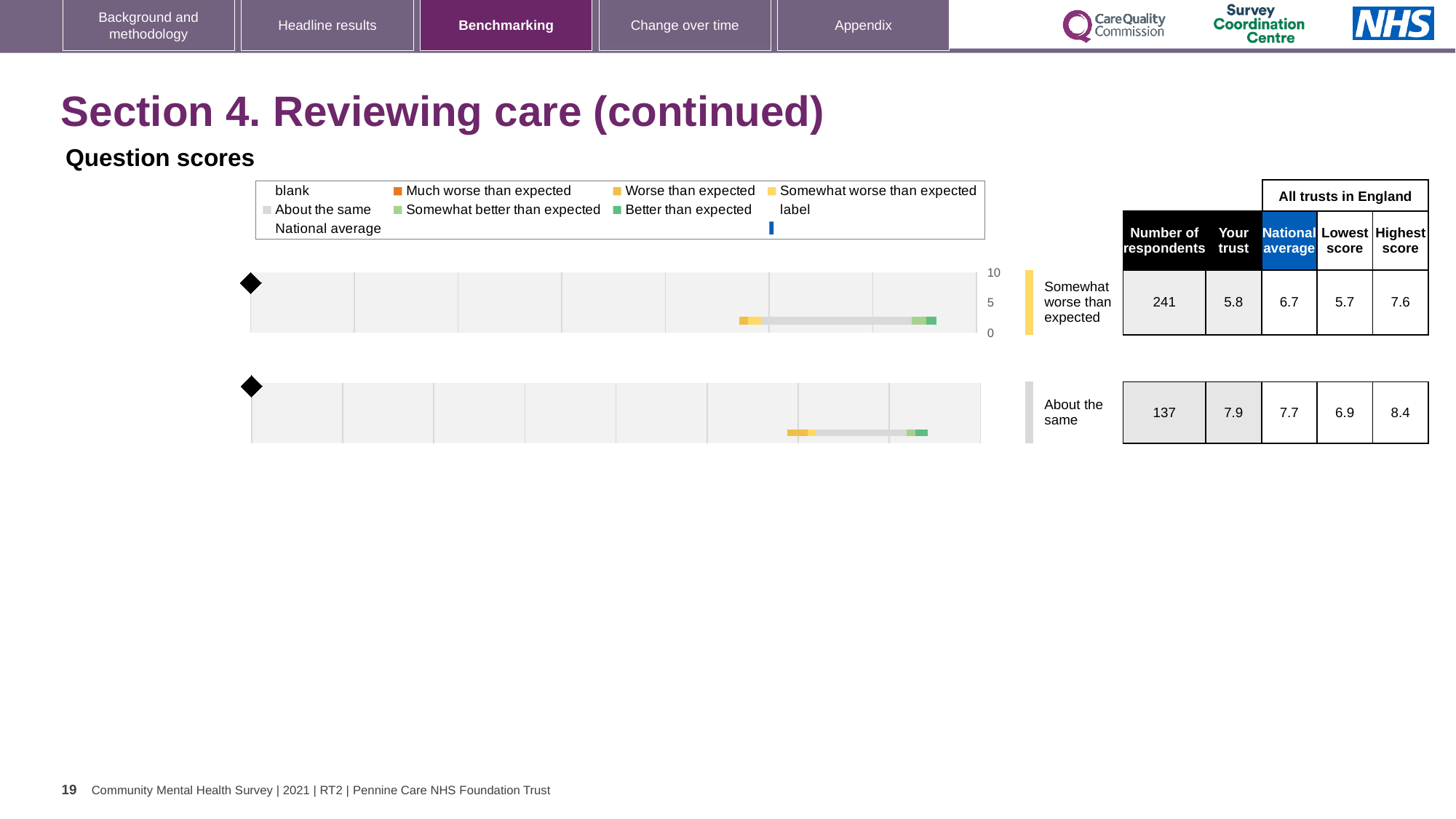
In the legend, what colour represents 'Much worse than expected'? orange Which chart has the higher 'Your trust' score, the top chart or the bottom chart? the bottom chart What kind of chart is used on this slide? bar chart What is the maximum value shown on the chart axis? 10 For the bottom chart (rated 'About the same'), what is the national average? 7.7 For the top chart (rated 'Somewhat worse than expected'), what is the difference between the highest score and the lowest score? 1.9 In the legend, what colour represents 'Better than expected'? green For the top chart (rated 'Somewhat worse than expected'), what is the 'Your trust' score? 5.8 How many charts are shown on the slide? 2 For the top chart, is the national average greater or less than 5? greater For the top chart (rated 'Somewhat worse than expected'), how many respondents are there? 241 For the bottom chart (rated 'About the same'), what is the highest score among all trusts in England? 8.4